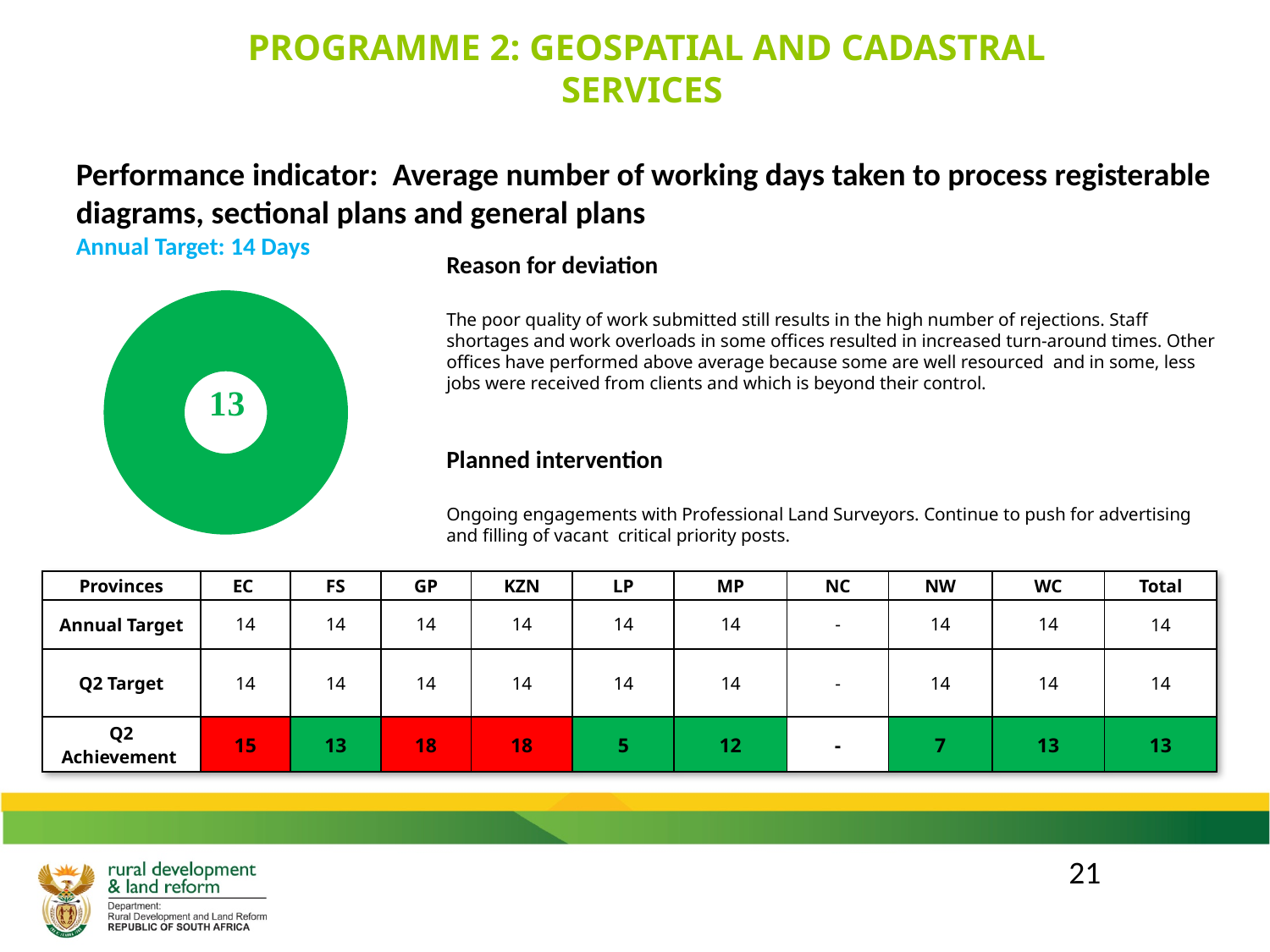
How many slices does the doughnut chart show? 1 Is the value shown in the centre of the doughnut chart greater or less than the annual target of 14 days stated on the slide? less What kind of chart is shown on the left of the slide? doughnut chart What colour is the ring of the doughnut chart? green What value is printed in the centre of the doughnut chart? 13